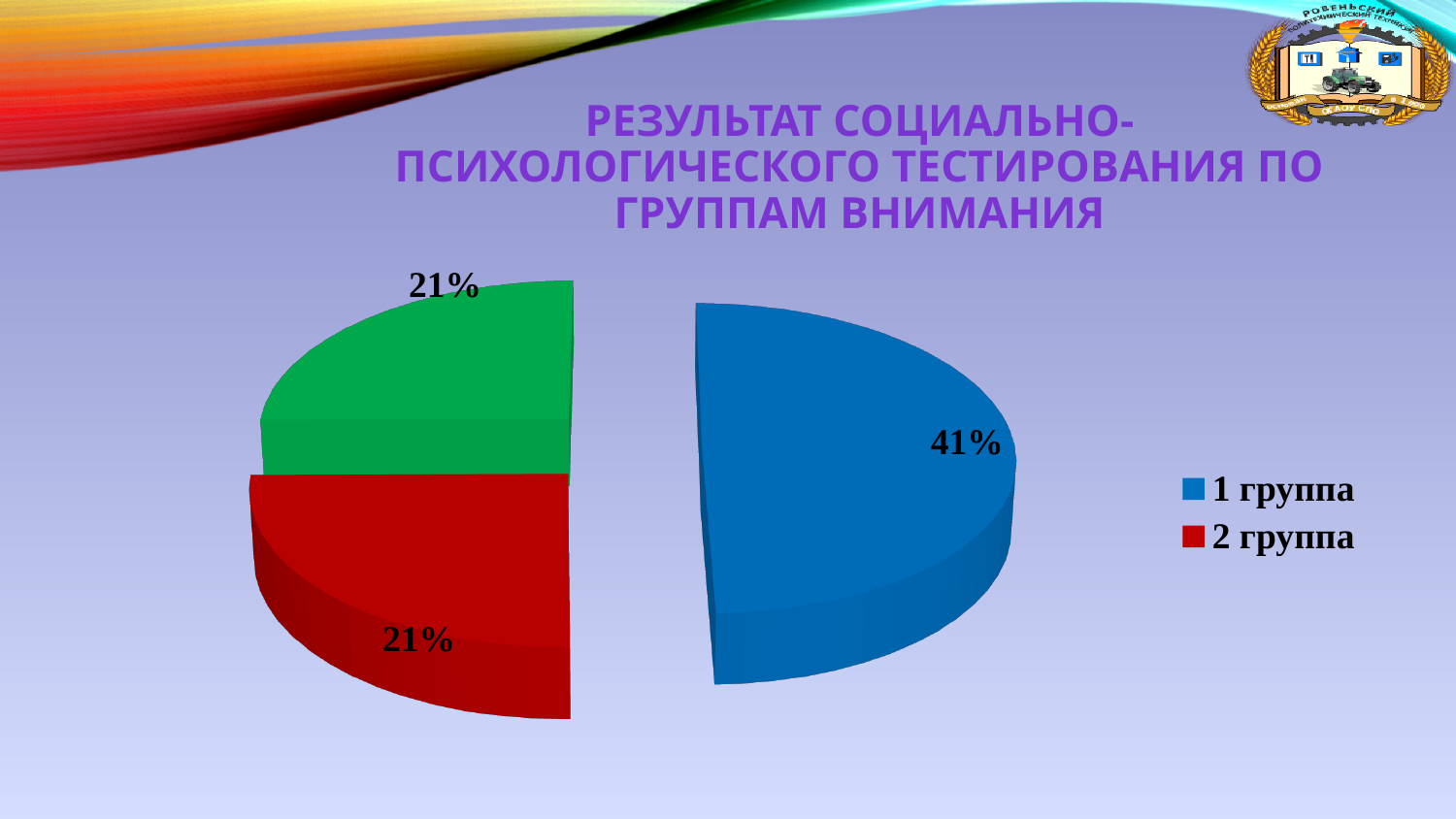
What is the difference between the value for 1 группа and the value for 2 группа? 20% What colour is the slice for 2 группа? red Which group has the largest slice of the pie? 1 группа How many slices does the pie chart have? 3 How many entries does the legend list? 2 What is the value shown on the green slice of the pie? 21% What is the value shown for 2 группа? 21% What colour is the slice for 1 группа? blue Which is larger, the value for 1 группа or the value for 2 группа? 1 группа What kind of chart is shown on the slide? pie chart What share of the pie does the blue slice represent? 41% What is the value shown for 1 группа? 41%